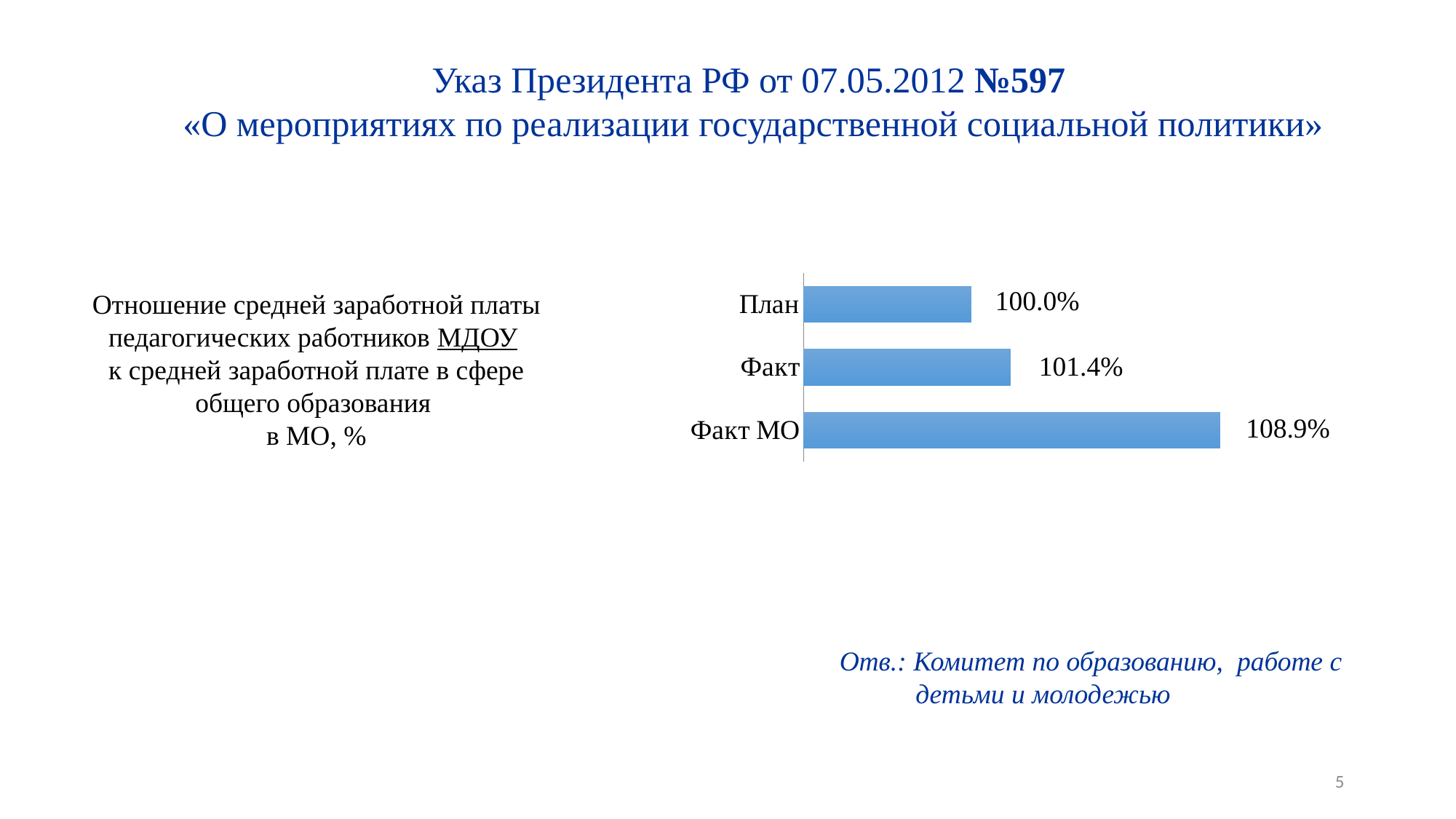
What is the value for Факт? 101.4% What is the value for Факт МО? 108.9% What is the value for План? 100.0% What is the difference between the values for Факт МО and План? 8.9% Which category is listed at the bottom of the chart? Факт МО How many categories are shown in the chart? 3 Which category has the lowest value? План Which is larger, the value for Факт МО or the value for Факт? Факт МО What kind of chart is shown on the slide? bar chart What is the difference between the values for Факт and План? 1.4% What colour are the bars in the chart? blue Which category has the highest value? Факт МО